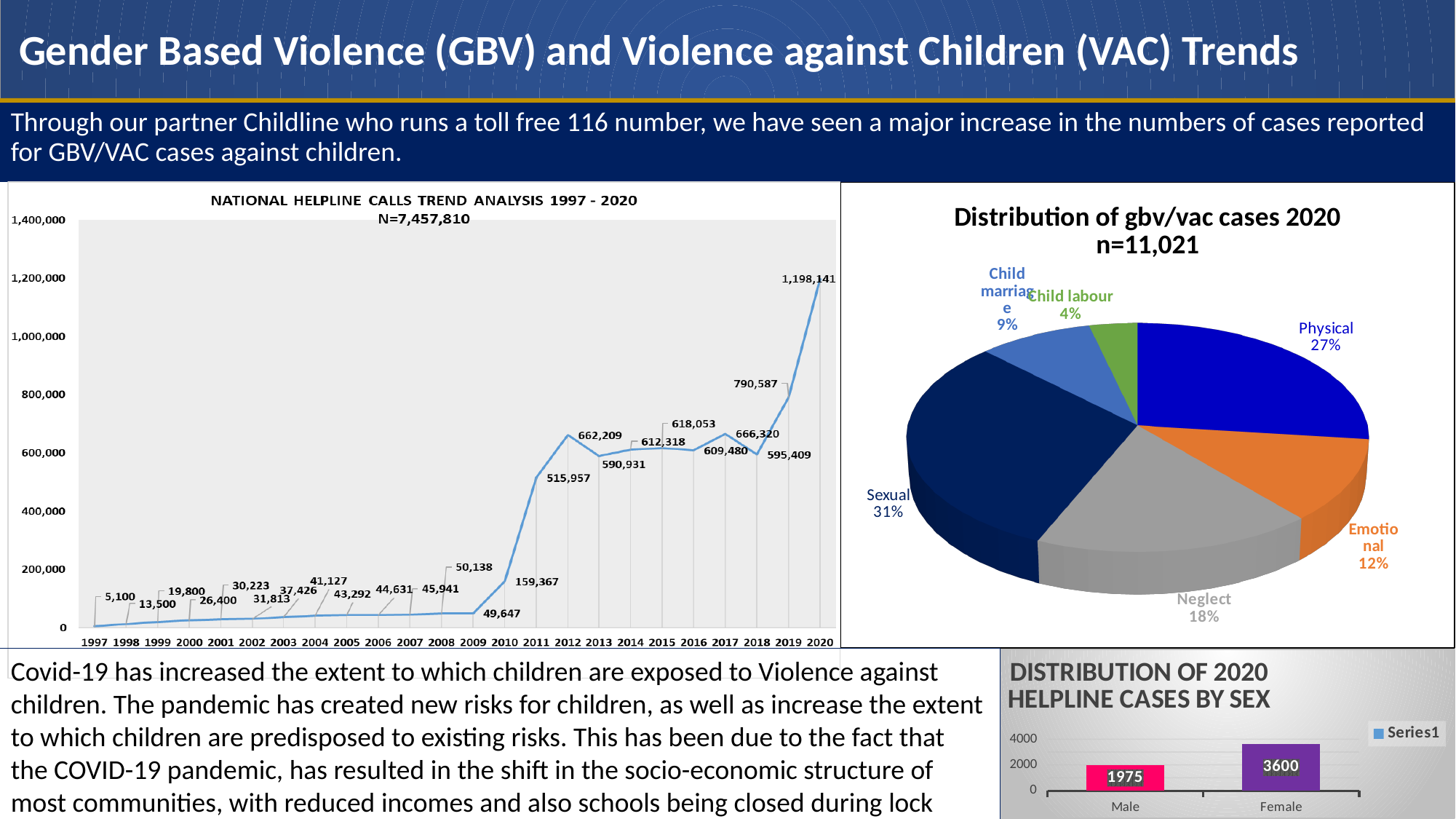
What kind of chart is the Distribution of 2020 Helpline Cases by Sex chart? bar chart In the National Helpline Calls Trend Analysis chart, which is larger, the value for 2012 or the value for 2013? 2012 In the National Helpline Calls Trend Analysis chart, what is the value for 2020? 1,198,141 In the Distribution of gbv/vac cases 2020 pie chart, what share is Sexual? 31% In the National Helpline Calls Trend Analysis chart, what is the difference between the 2020 and 2019 values? 407,554 In the Distribution of 2020 Helpline Cases by Sex chart, what is the value for Female? 3600 In the Distribution of 2020 Helpline Cases by Sex chart, what is the difference between the Female and Male values? 1625 In the National Helpline Calls Trend Analysis chart, what is the value for 2011? 515,957 What kind of chart is the National Helpline Calls Trend Analysis chart? line chart In the Distribution of gbv/vac cases 2020 pie chart, which category has the smallest share? Child labour How many categories does the Distribution of gbv/vac cases 2020 pie chart show? 6 In the National Helpline Calls Trend Analysis chart, which year has the lowest value? 1997